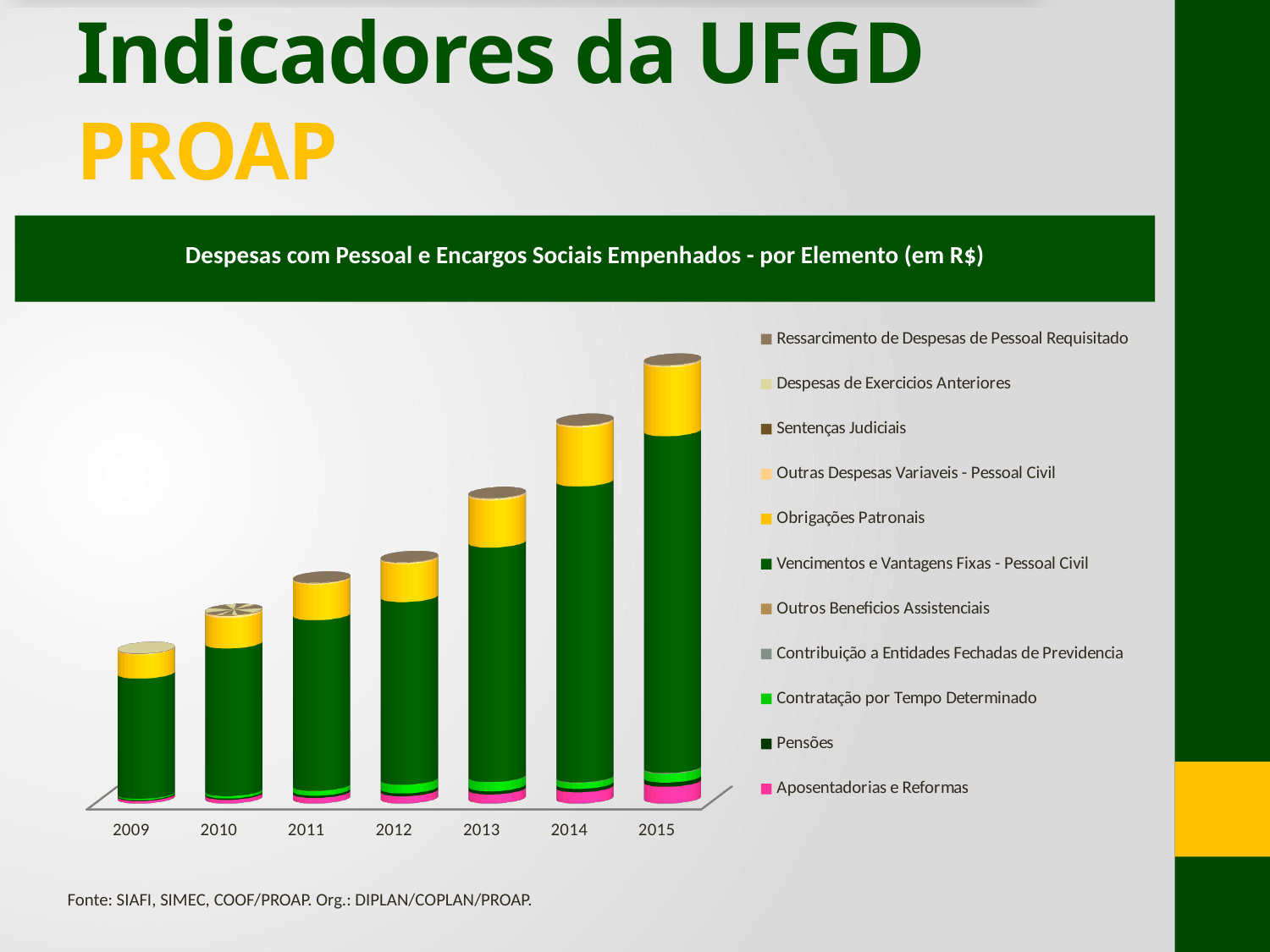
Which year has a taller stacked bar, 2012 or 2014? 2014 How many years are shown along the x axis of the chart? 7 Which year has the tallest stacked bar? 2015 How many series does the chart legend list? 11 Do the total stacked bar heights rise or fall from 2009 to 2015? Rise Which series is shown in yellow in the legend? Obrigações Patronais What is the title of the chart? Despesas com Pessoal e Encargos Sociais Empenhados - por Elemento (em R$) What kind of chart is shown on the slide? Stacked bar chart Which year has the shortest stacked bar? 2009 Which series makes up the largest segment of each bar? Vencimentos e Vantagens Fixas - Pessoal Civil What is the first year shown on the x axis? 2009 Which year has a taller stacked bar, 2010 or 2009? 2010